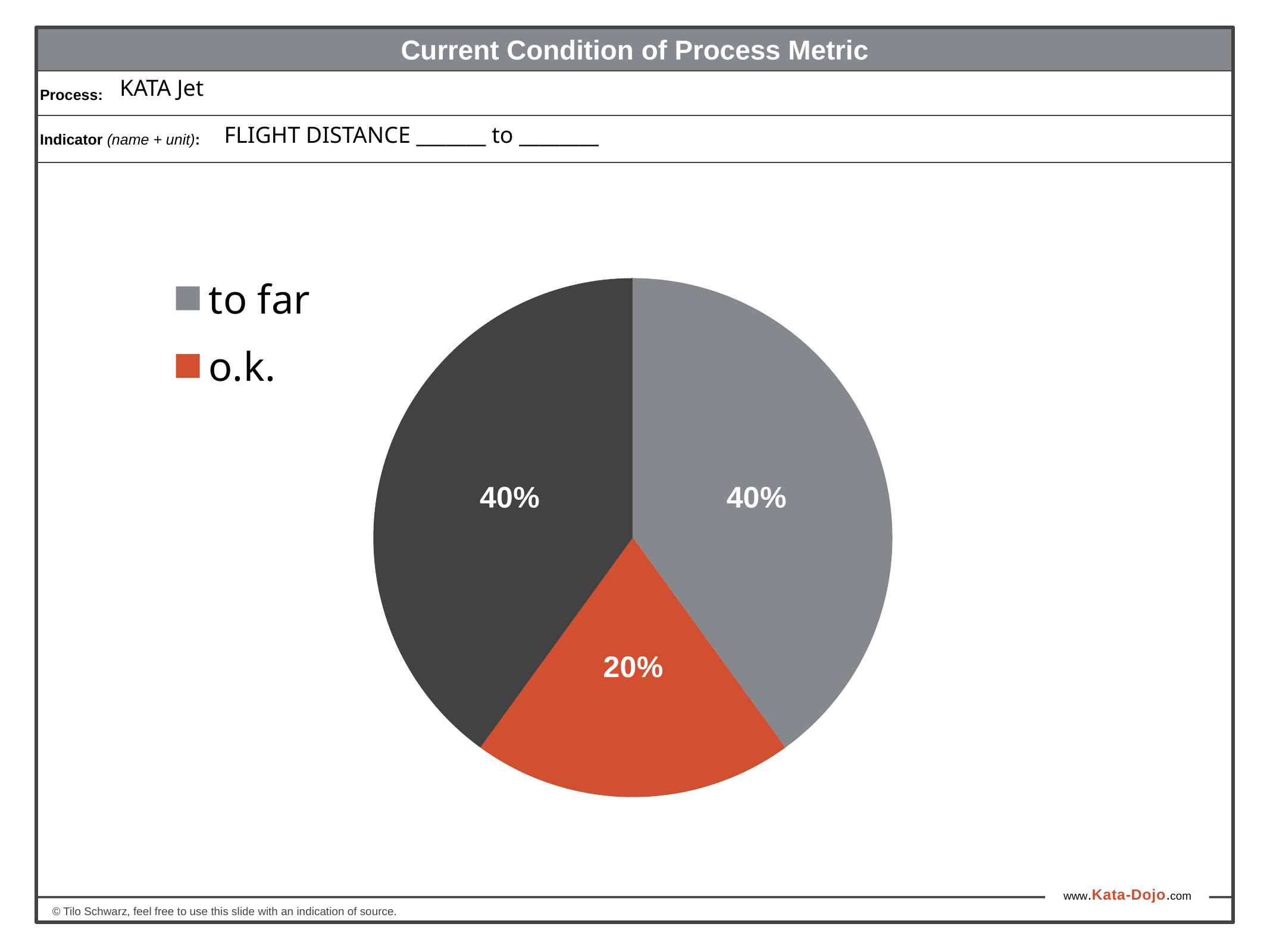
Which legend category has the smallest slice of the pie? o.k. What is the difference in percentage points between the "to far" slice and the "o.k." slice? 20 What colour is the "o.k." category in the legend? red What kind of chart is shown on the slide? pie chart What share of the pie does the "o.k." slice represent? 20% What is the percentage label shown on the red slice? 20% What share of the pie does the "to far" slice represent? 40% How many slices does the pie chart have? 3 What is the title shown at the top of the slide? Current Condition of Process Metric Which slice is larger, "to far" or "o.k."? to far How many entries does the legend list? 2